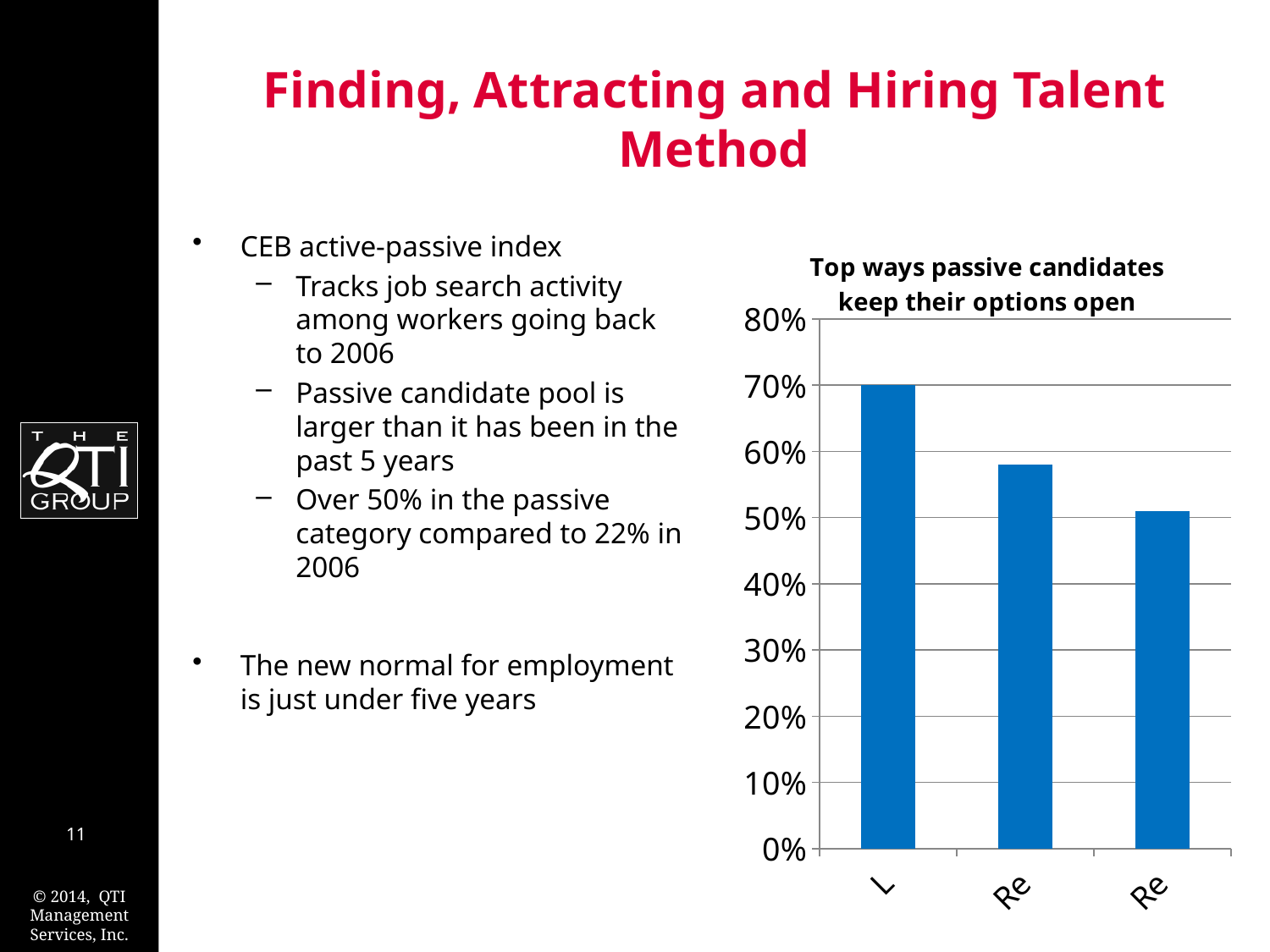
Is the value of the third (rightmost) bar greater or less than 60%? less What is the title of the chart? Top ways passive candidates keep their options open Which is larger, the first bar or the third bar? the first bar What is the highest value shown on the chart's vertical axis? 80% Is the value of the second bar greater or less than 50%? greater Which bar is the tallest in the chart? the first (leftmost) bar Is the value of the second bar greater or less than 60%? less What kind of chart is shown on the slide? bar chart Do the bar values rise or fall from left to right across the chart? fall How many bars are plotted in the chart? 3 Which bar is the shortest in the chart? the third (rightmost) bar What value does the first (leftmost) bar reach on the axis? 70%